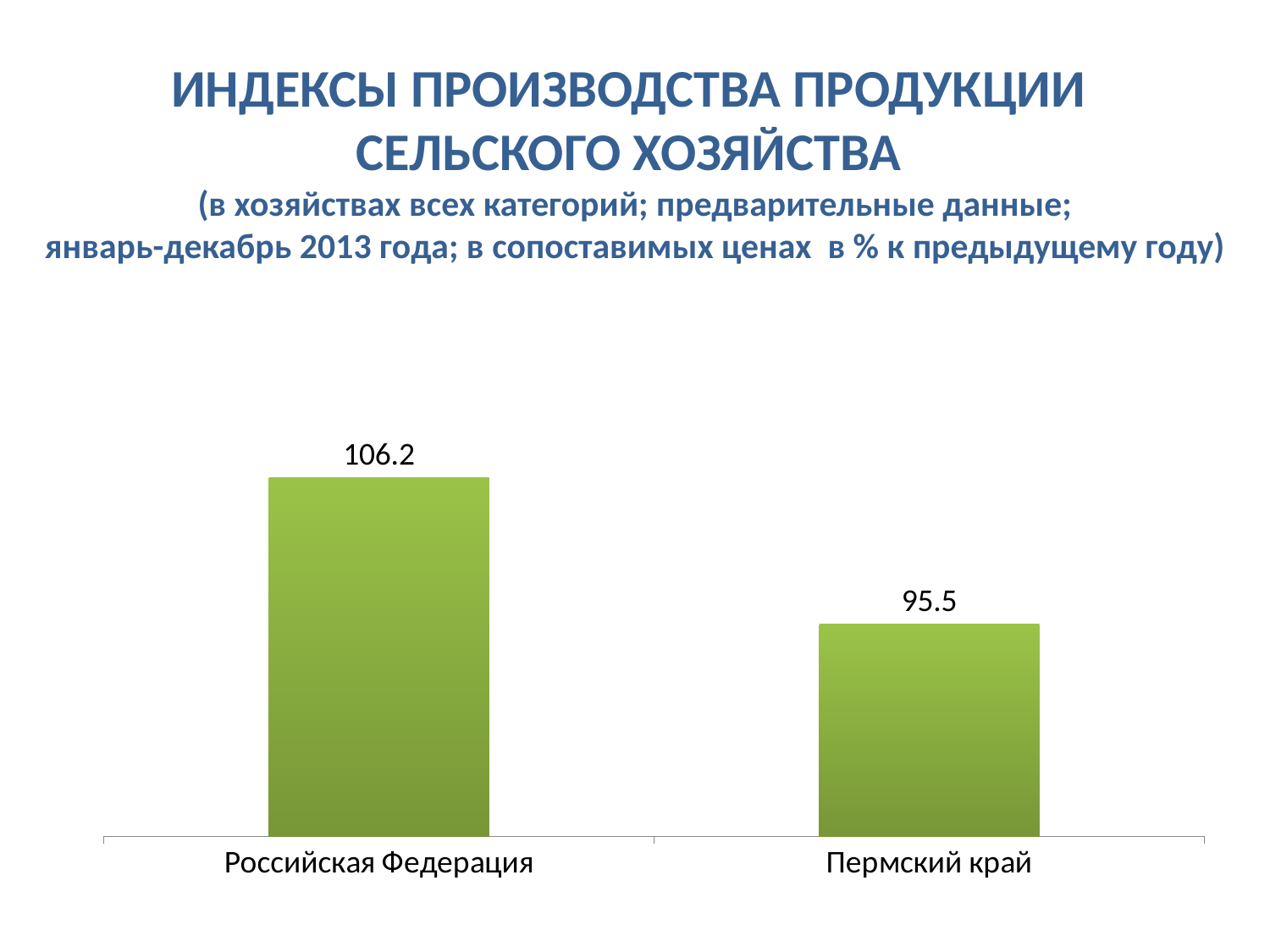
Which is larger, the value for Российская Федерация or the value for Пермский край? Российская Федерация What is the difference between the values for Российская Федерация and Пермский край? 10.7 What is the value for Российская Федерация? 106.2 What is the value for Пермский край? 95.5 What kind of chart is shown on the slide? Bar chart Which category has the lowest value? Пермский край Which category has the highest value? Российская Федерация What colour are the bars in the chart? Green What is the title of the chart on the slide? ИНДЕКСЫ ПРОИЗВОДСТВА ПРОДУКЦИИ СЕЛЬСКОГО ХОЗЯЙСТВА Do the values rise or fall from left to right along the x axis? Fall How many categories are shown in the chart? 2